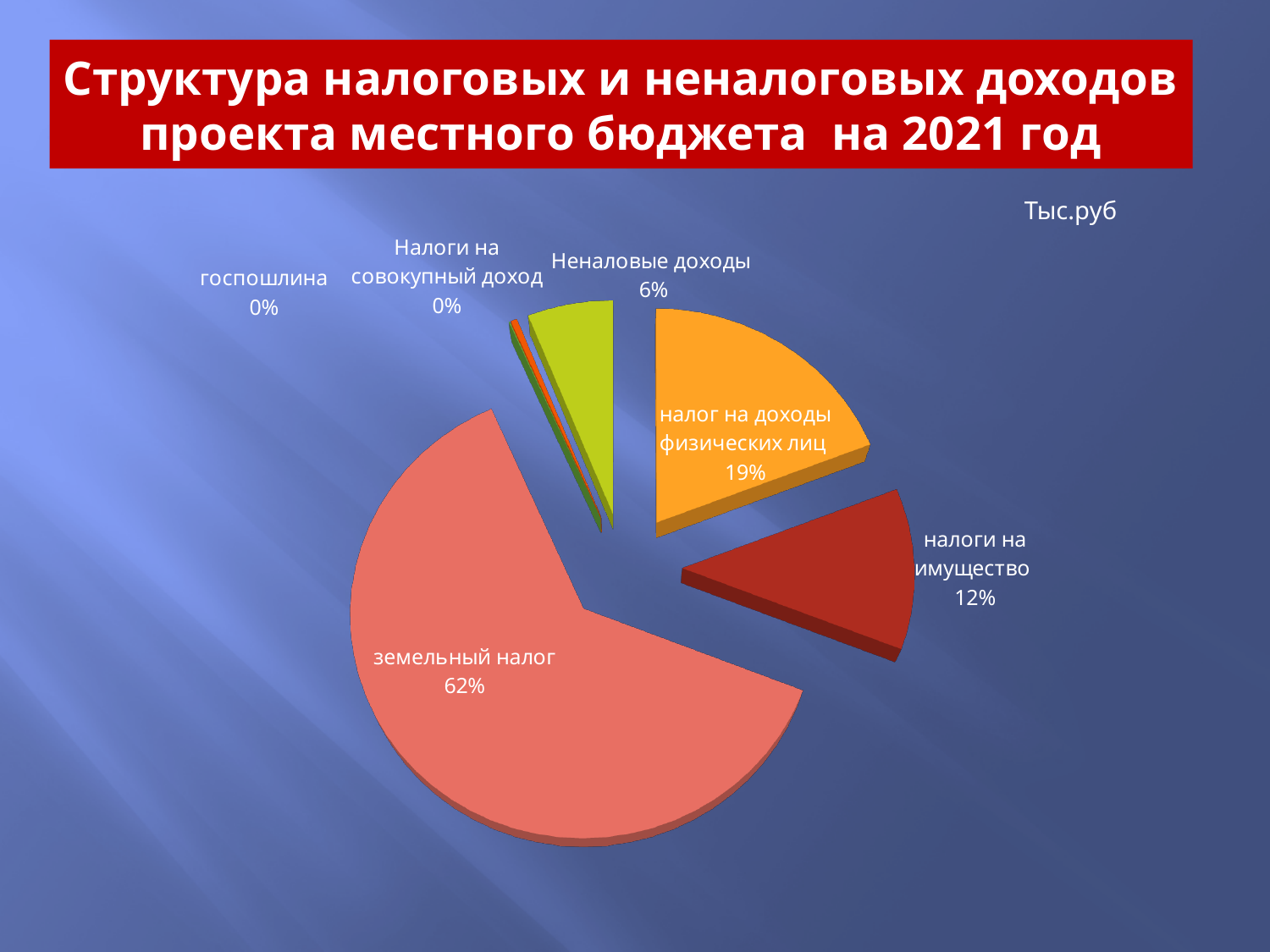
What is the difference in percentage points between налоги на имущество and Неналовые доходы? 6 What percentage is shown for налоги на имущество? 12% What percentage is shown for Неналовые доходы? 6% Which category has the largest share of the pie? земельный налог How many categories are labelled on the pie chart? 6 What kind of chart is shown on the slide? pie chart Which is larger, налог на доходы физических лиц or налоги на имущество? налог на доходы физических лиц What percentage is shown for налог на доходы физических лиц? 19% What percentage is shown for госпошлина? 0% What is the difference in percentage points between земельный налог and налог на доходы физических лиц? 43 What share of the pie does земельный налог account for? 62% What unit is indicated in the top right corner above the chart? Тыс.руб